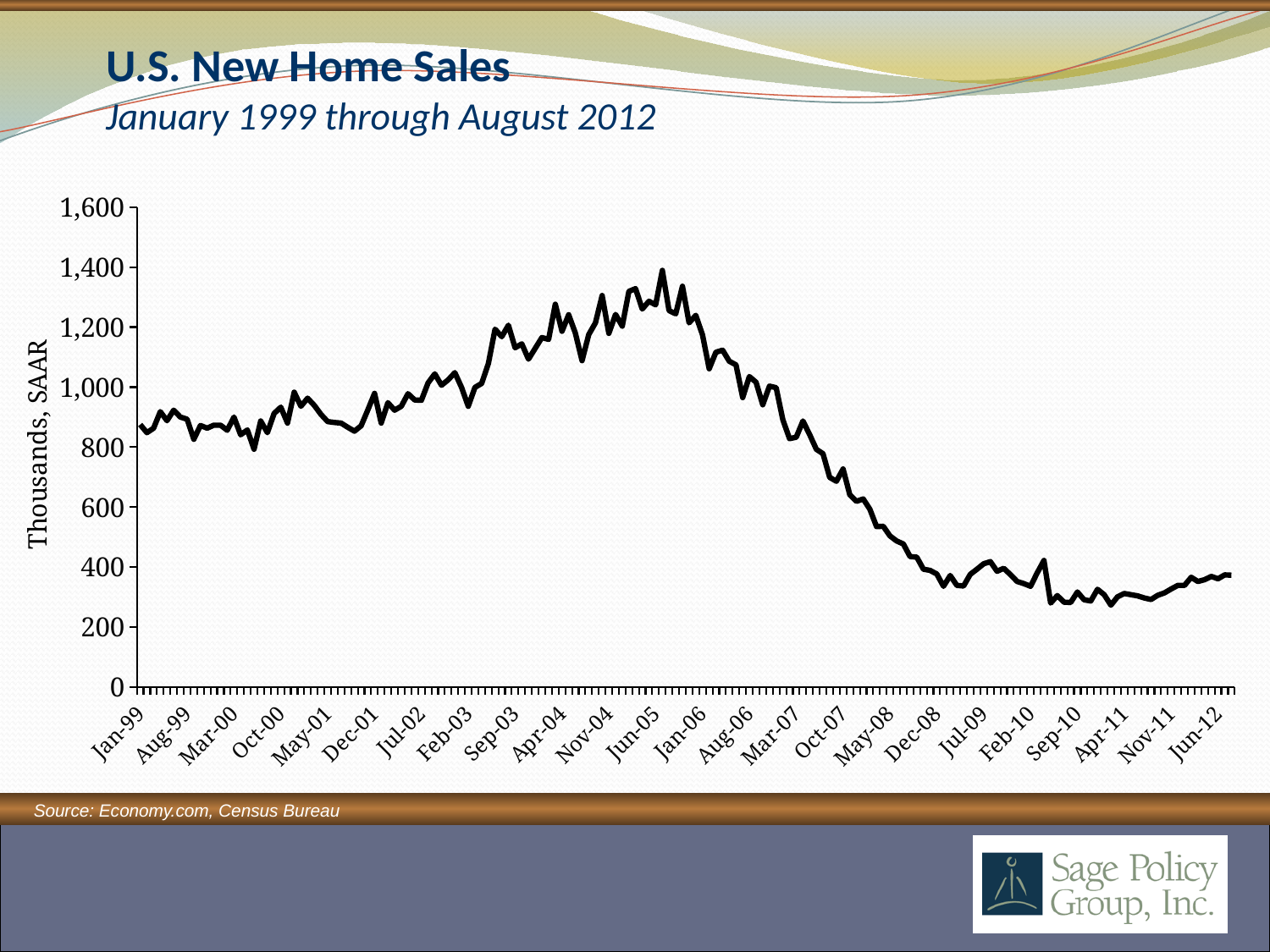
Is the value for Oct-07 greater or less than 1,000? less Which is larger, the value for Jun-05 or the value for Mar-07? Jun-05 Which is larger, the value for Jan-99 or the value for Jun-12? Jan-99 Is the value for Jan-99 greater or less than 800? greater What is the label on the vertical axis of the chart? Thousands, SAAR Is the value for Jul-09 greater or less than 600? less Near which labeled x-axis date does the line reach its highest point? Jun-05 What kind of chart is shown on the slide? Line chart Do the values rise or fall between Jan-06 and Dec-08? fall What is the title of the chart? U.S. New Home Sales